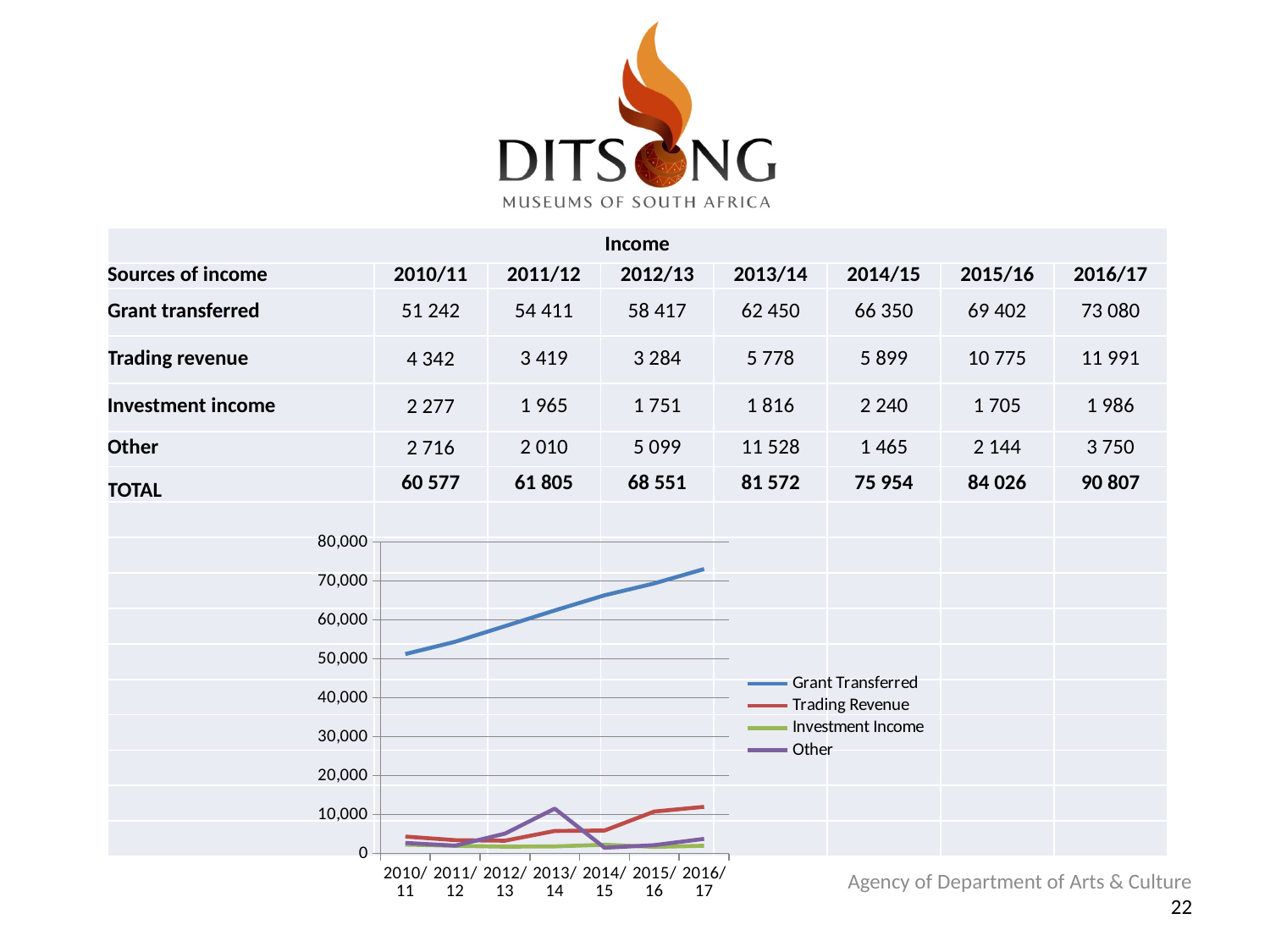
Which series has the highest values across all years in the chart? Grant Transferred Is the value for Grant Transferred in 2010/11 greater or less than 60,000? less How many series does the chart legend list? 4 Is the value for Grant Transferred in 2016/17 greater or less than 70,000? greater According to the table, what was the Grant transferred in 2014/15? 66 350 Which colour is used for the Other series in the chart? purple According to the table, what was the TOTAL income in 2016/17? 90 807 Does the Grant Transferred line rise or fall from 2010/11 to 2016/17? rises What kind of chart is shown on the slide? line chart How many years are shown along the x axis of the chart? 7 In 2013/14, which is larger: Other or Trading Revenue? Other Is the value for Trading Revenue in 2016/17 greater or less than 10,000? greater